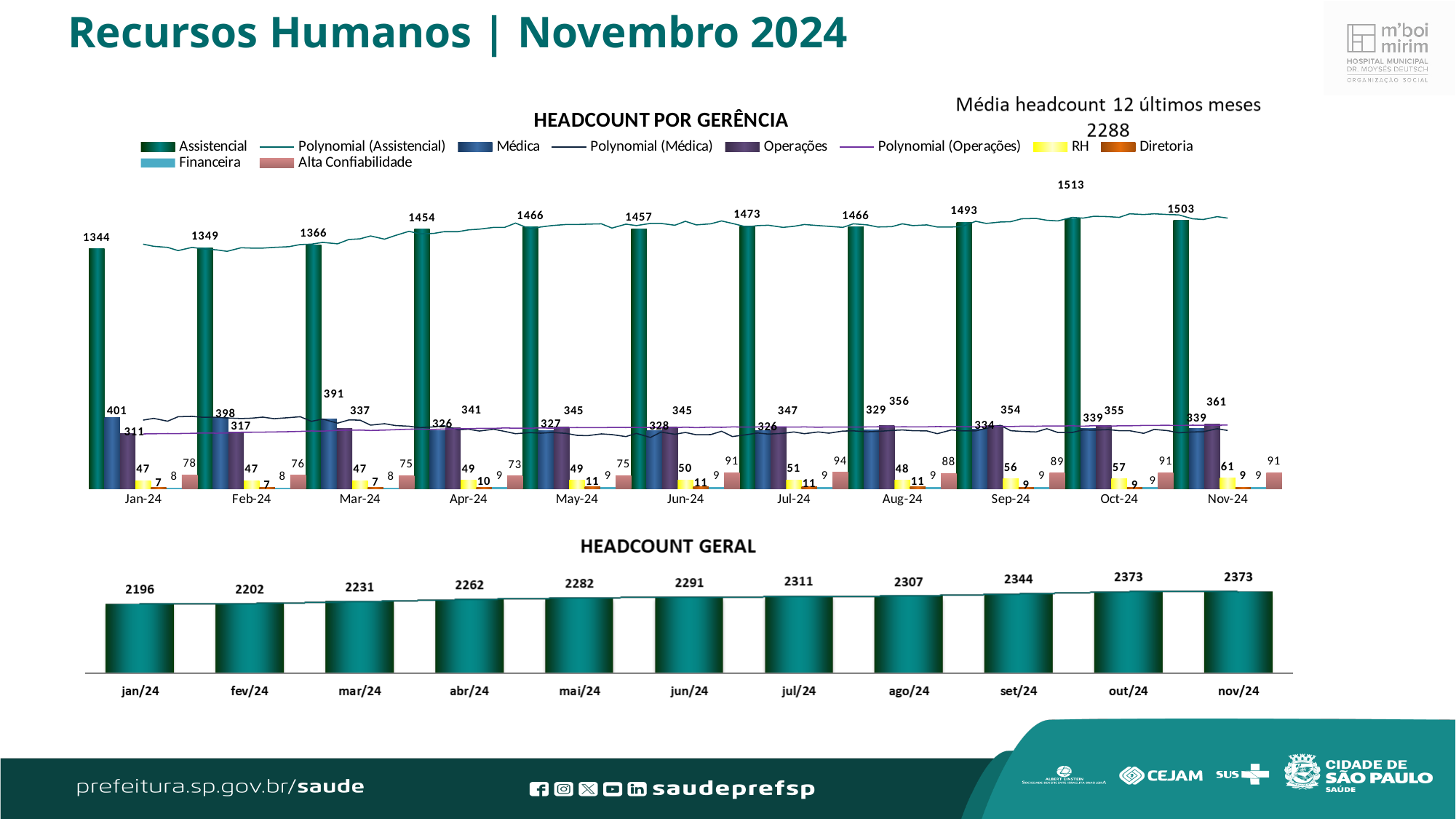
In the HEADCOUNT POR GERÊNCIA chart, what is the Operações value for Nov-24? 361 What kind of chart is the HEADCOUNT GERAL chart? bar chart In the HEADCOUNT GERAL chart, what is the value for set/24? 2344 In the HEADCOUNT POR GERÊNCIA chart, what is the difference between the Assistencial values for Nov-24 and Jan-24? 159 In the HEADCOUNT GERAL chart, how many months are shown on the x axis? 11 In the HEADCOUNT GERAL chart, do the values generally rise or fall from jan/24 to nov/24? rise How many series does the legend of the HEADCOUNT POR GERÊNCIA chart list? 10 In the HEADCOUNT POR GERÊNCIA chart, which is larger in Nov-24: the Médica value or the Operações value? Operações In the HEADCOUNT POR GERÊNCIA chart, which month has the lowest Assistencial value? Jan-24 In the HEADCOUNT POR GERÊNCIA chart, what is the Assistencial value for Oct-24? 1513 In the HEADCOUNT POR GERÊNCIA chart, which month has the highest Assistencial value? Oct-24 In the HEADCOUNT POR GERÊNCIA chart, what is the Médica value for Jan-24? 401